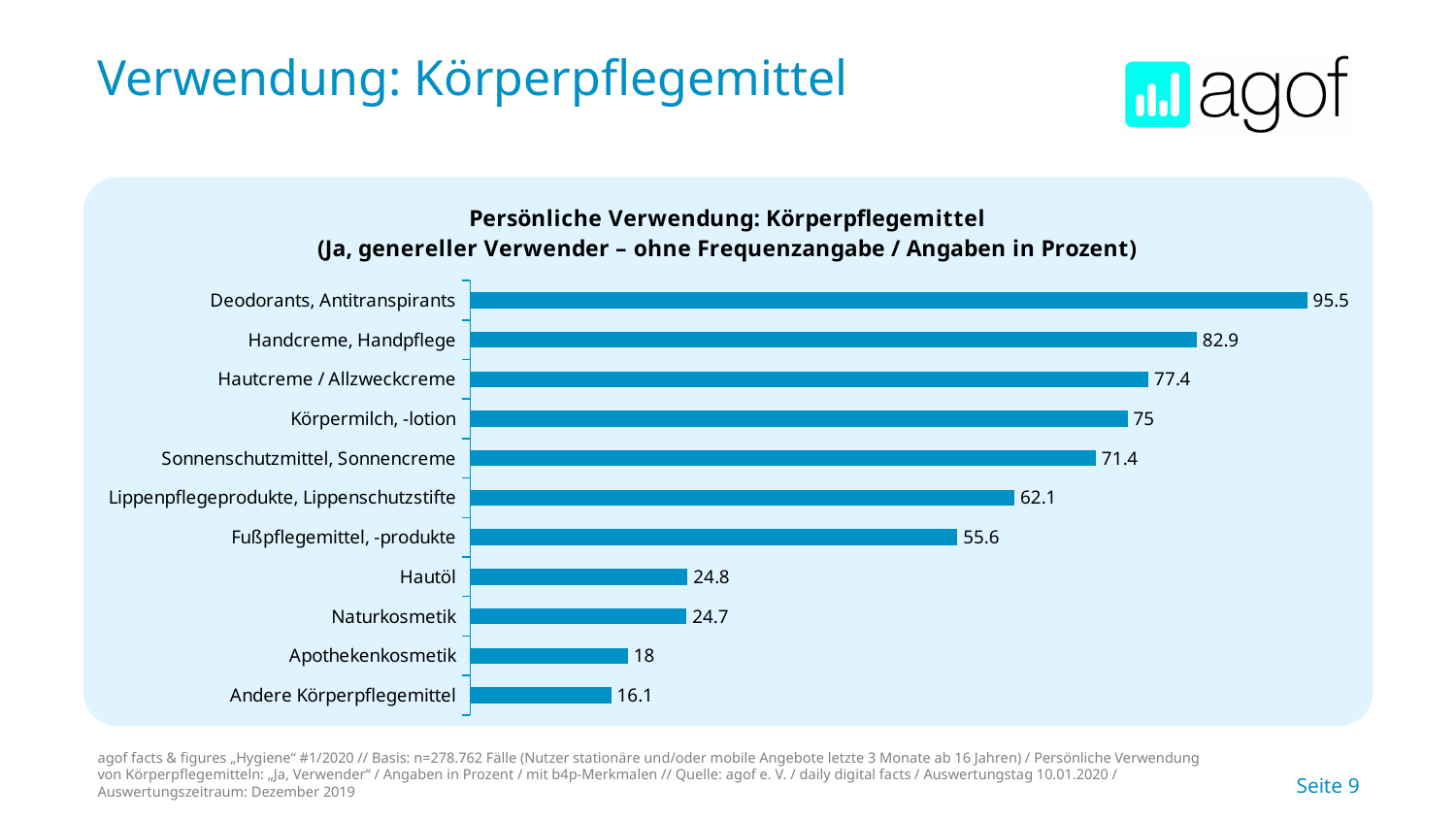
What is the value for Deodorants, Antitranspirants? 95.5 What is the value for Körpermilch, -lotion? 75 How many categories are shown in the chart? 11 Which category has the highest value? Deodorants, Antitranspirants Which is larger, the value for Lippenpflegeprodukte, Lippenschutzstifte or the value for Fußpflegemittel, -produkte? Lippenpflegeprodukte, Lippenschutzstifte What kind of chart is shown on the slide? Bar chart What is the title of the chart? Persönliche Verwendung: Körperpflegemittel (Ja, genereller Verwender – ohne Frequenzangabe / Angaben in Prozent) What is the difference between the values for Fußpflegemittel, -produkte and Hautöl? 30.8 What is the value for Apothekenkosmetik? 18 What is the difference between the values for Handcreme, Handpflege and Hautcreme / Allzweckcreme? 5.5 Which category has the lowest value? Andere Körperpflegemittel What is the value for Sonnenschutzmittel, Sonnencreme? 71.4